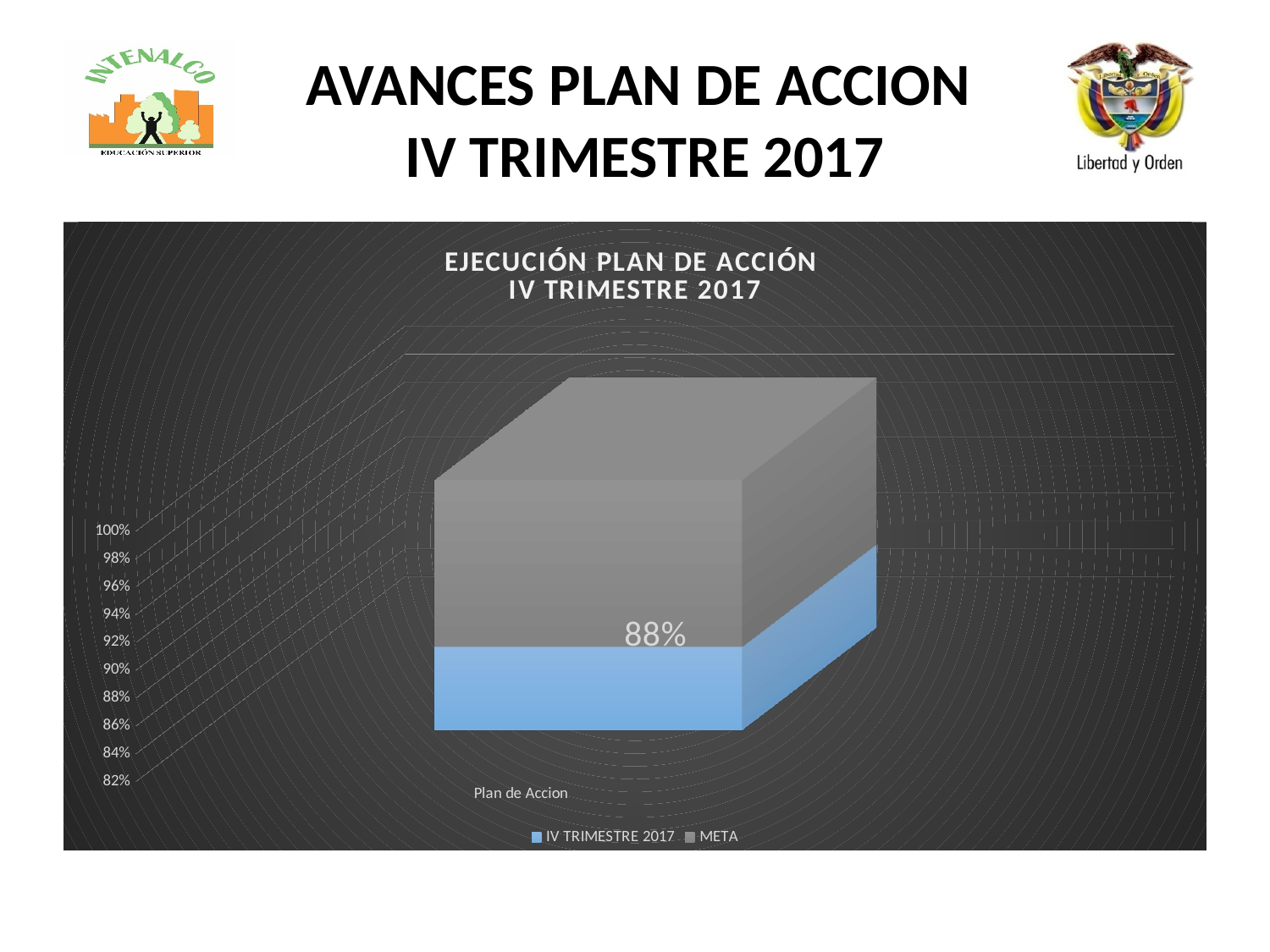
How many categories are shown on the x axis? 1 Which series has the lowest value for Plan de Accion? IV TRIMESTRE 2017 What is the name of the category shown on the x axis? Plan de Accion What is the title of the chart? EJECUCIÓN PLAN DE ACCIÓN IV TRIMESTRE 2017 What is the value for IV TRIMESTRE 2017 for Plan de Accion? 88% How many series does the legend list? 2 Which series has the highest value for Plan de Accion? META What colour represents the META series? Gray Which is larger for Plan de Accion, META or IV TRIMESTRE 2017? META What kind of chart is shown on the slide? Bar chart Is the value for IV TRIMESTRE 2017 greater or less than 90%? less